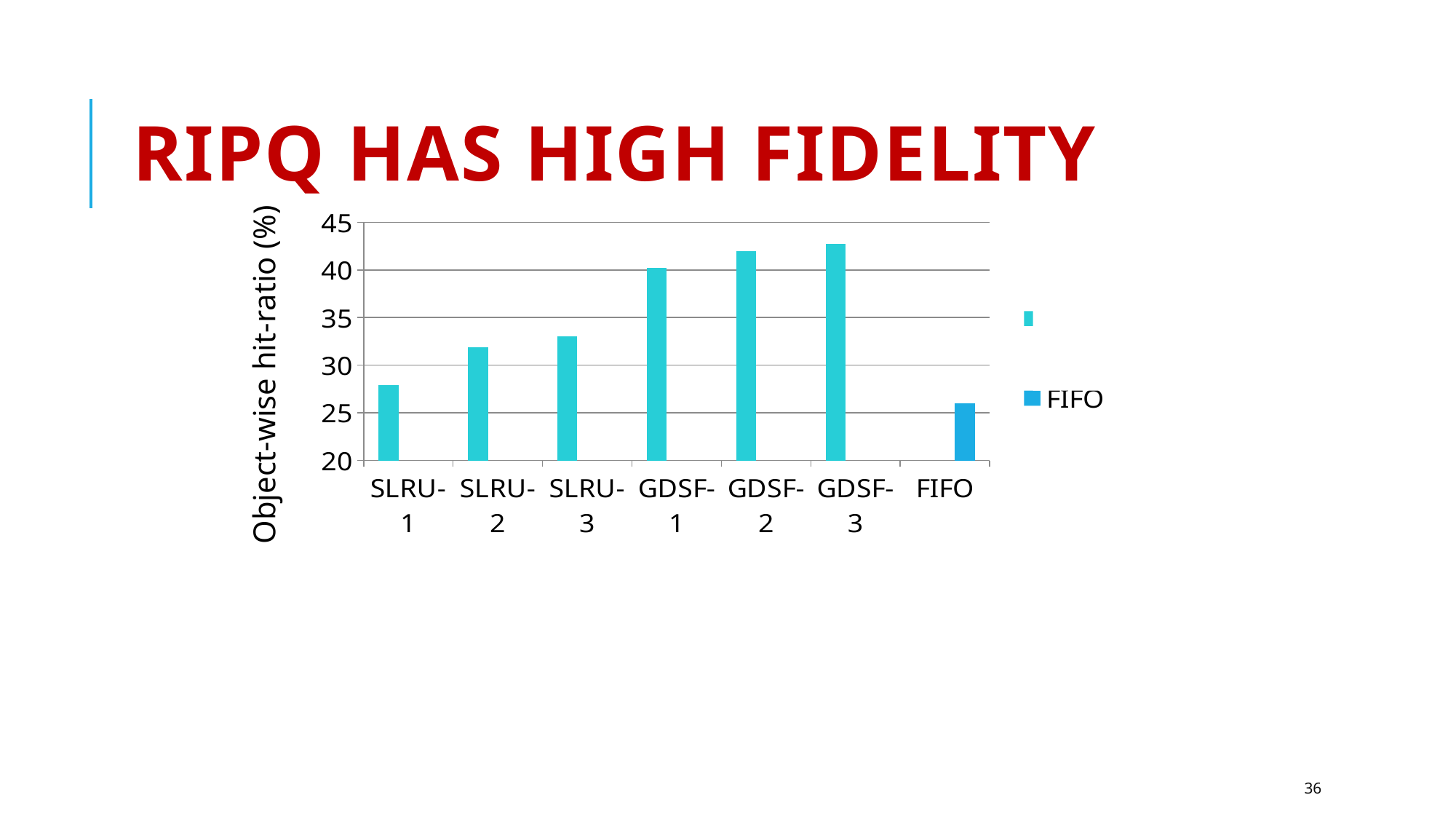
How many categories are shown on the x axis of the chart? 7 Is the value for GDSF-3 greater or less than 45? less Is the value for FIFO greater or less than 25? greater Which has a higher object-wise hit-ratio, SLRU-1 or FIFO? SLRU-1 What kind of chart is shown on the slide? bar chart Is the value for SLRU-1 greater or less than 30? less Do the values rise or fall from SLRU-1 to SLRU-3? rise Which has a higher object-wise hit-ratio, GDSF-1 or SLRU-3? GDSF-1 Which category has the lowest object-wise hit-ratio? FIFO What is the label on the vertical axis of the chart? Object-wise hit-ratio (%)